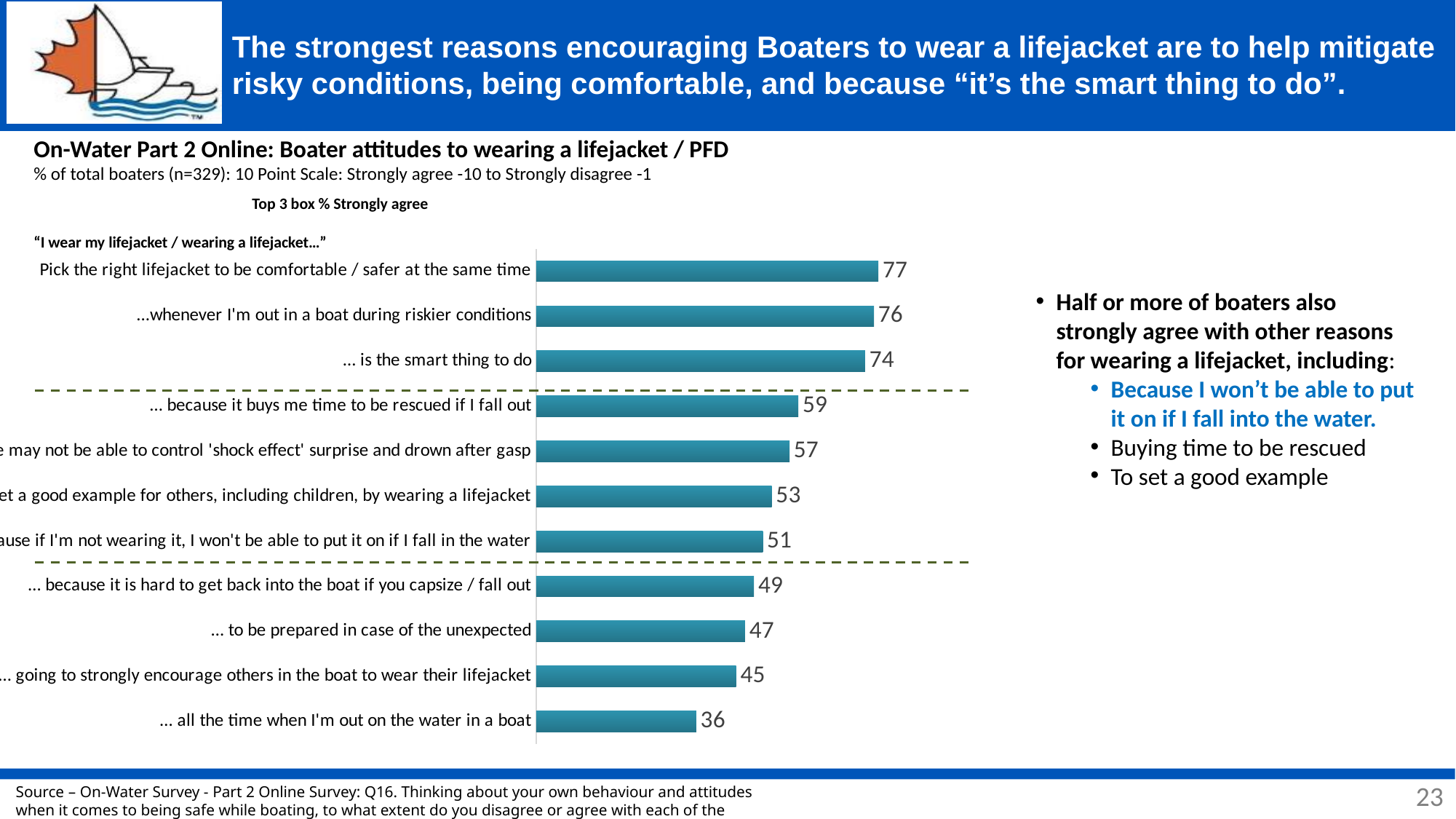
Which statement has the lowest value in the chart? ... all the time when I'm out on the water in a boat What is the difference between the value for "... because it buys me time to be rescued if I fall out" and the value for "... to be prepared in case of the unexpected"? 12 What is the title of the chart section on the slide? On-Water Part 2 Online: Boater attitudes to wearing a lifejacket / PFD What is the difference between the highest value (77) and the lowest value (36) in the chart? 41 What kind of chart is shown on the slide? Bar chart Which has a larger value: "... because it is hard to get back into the boat if you capsize / fall out" or "... all the time when I'm out on the water in a boat"? ... because it is hard to get back into the boat if you capsize / fall out What is the value for "Pick the right lifejacket to be comfortable / safer at the same time"? 77 What is the value for "... all the time when I'm out on the water in a boat"? 36 How many bars (statements) are plotted in the chart? 11 Which statement has the highest value in the chart? Pick the right lifejacket to be comfortable / safer at the same time What is the value for "... is the smart thing to do"? 74 What is the value for "...whenever I'm out in a boat during riskier conditions"? 76